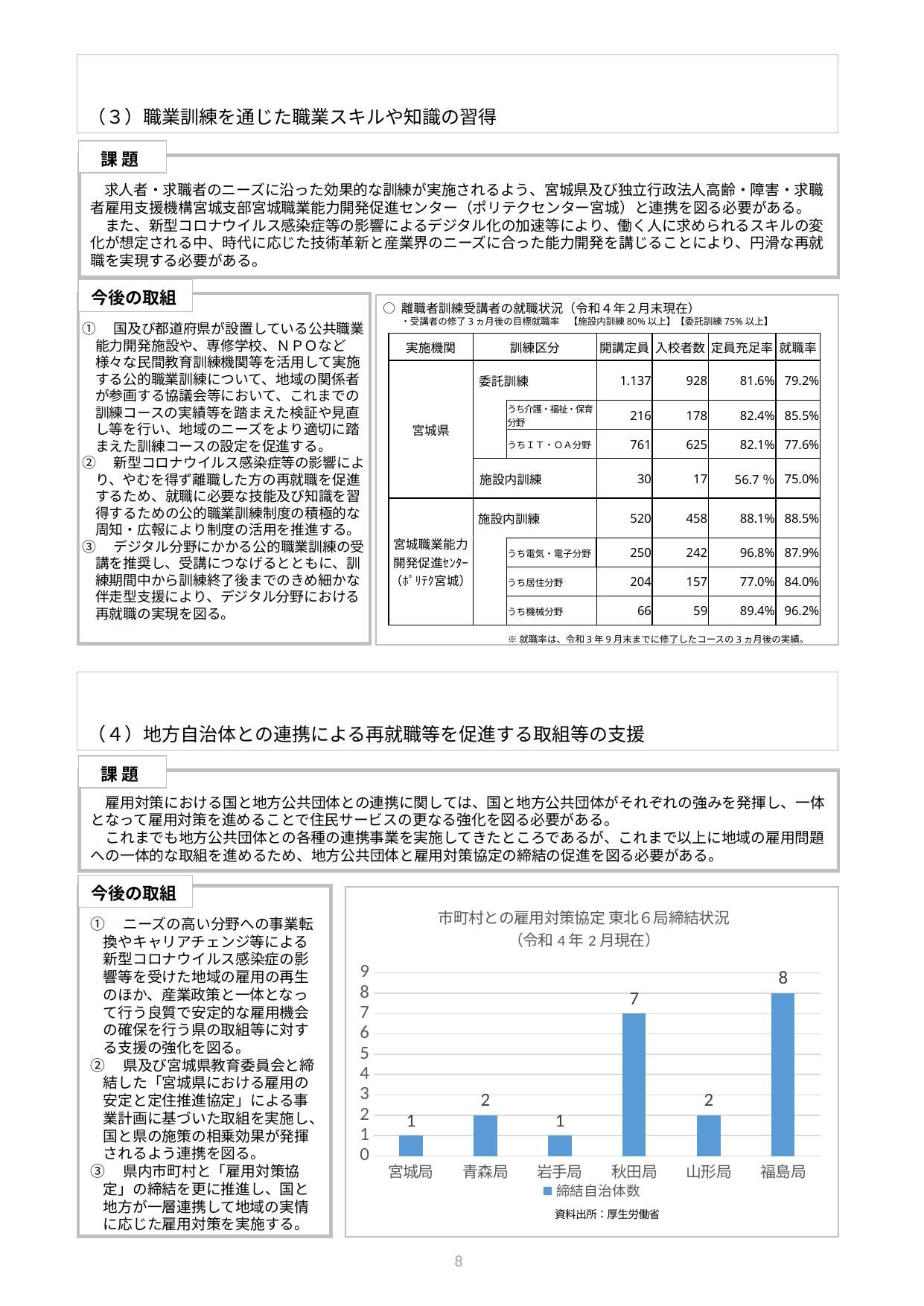
How many series does the chart legend list? 1 What is the value for 福島局 in the chart? 8 What is the value for 山形局 in the chart? 2 What is the value for 秋田局 in the chart? 7 How many categories are shown on the x axis of the chart? 6 What is the value for 宮城局 in the chart? 1 What is the legend entry of the chart? 締結自治体数 Which category has the highest value in the chart? 福島局 What is the difference between the values for 福島局 and 秋田局? 1 What type of chart is shown on the slide? bar chart Which is larger, the value for 青森局 or the value for 岩手局? 青森局 What is the difference between the values for 秋田局 and 青森局? 5